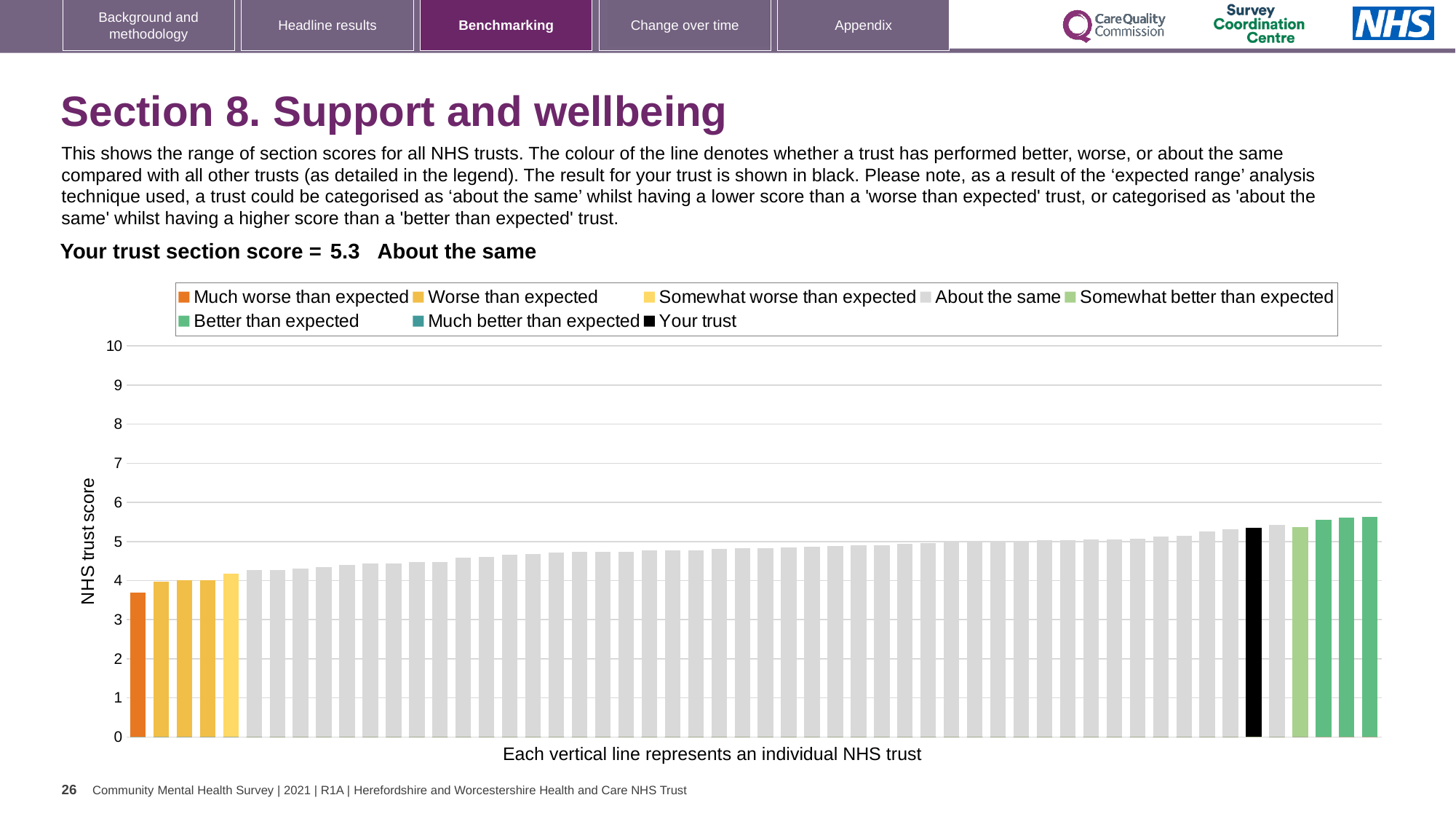
Which category does your trust's section score fall into according to the slide? About the same How many bars are coloured as 'Better than expected'? 3 Do the bar values rise or fall from left to right along the x axis? rise What kind of chart is shown on the slide? bar chart How many bars are coloured as 'Much worse than expected'? 1 Is the value of the highest bar on the chart greater or less than 6? less What is the section score for your trust shown on the slide? 5.3 Is the value of the black 'Your trust' bar greater or less than 5? greater What is the label of the y axis? NHS trust score Is the value of the lowest bar (the orange 'Much worse than expected' bar) greater or less than 4? less How many entries does the chart legend list? 8 What colour is the bar representing your trust? black